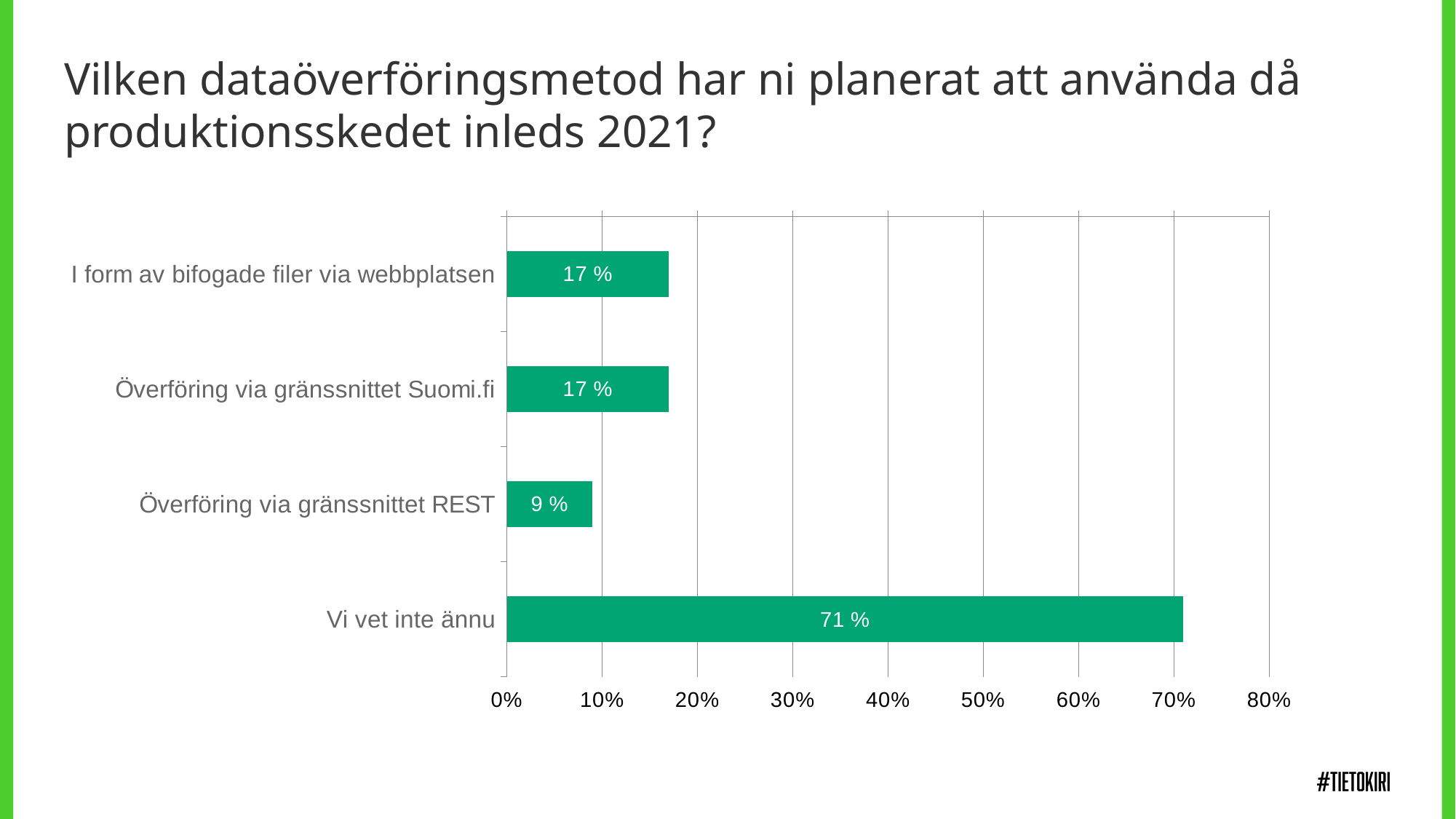
Which is larger, the value for "Vi vet inte ännu" or the value for "I form av bifogade filer via webbplatsen"? Vi vet inte ännu What kind of chart is shown on the slide? Bar chart What is the value for "Överföring via gränssnittet REST"? 9 % What is the difference between the values for "Vi vet inte ännu" and "Överföring via gränssnittet REST"? 62 % What is the difference between the values for "Överföring via gränssnittet Suomi.fi" and "Överföring via gränssnittet REST"? 8 % Which category has the lowest value? Överföring via gränssnittet REST What is the value for "Överföring via gränssnittet Suomi.fi"? 17 % What is the value for "Vi vet inte ännu"? 71 % What is the value for "I form av bifogade filer via webbplatsen"? 17 % How many categories are shown in the chart? 4 Which category has the highest value? Vi vet inte ännu Is the value for "Vi vet inte ännu" greater or less than 50%? greater